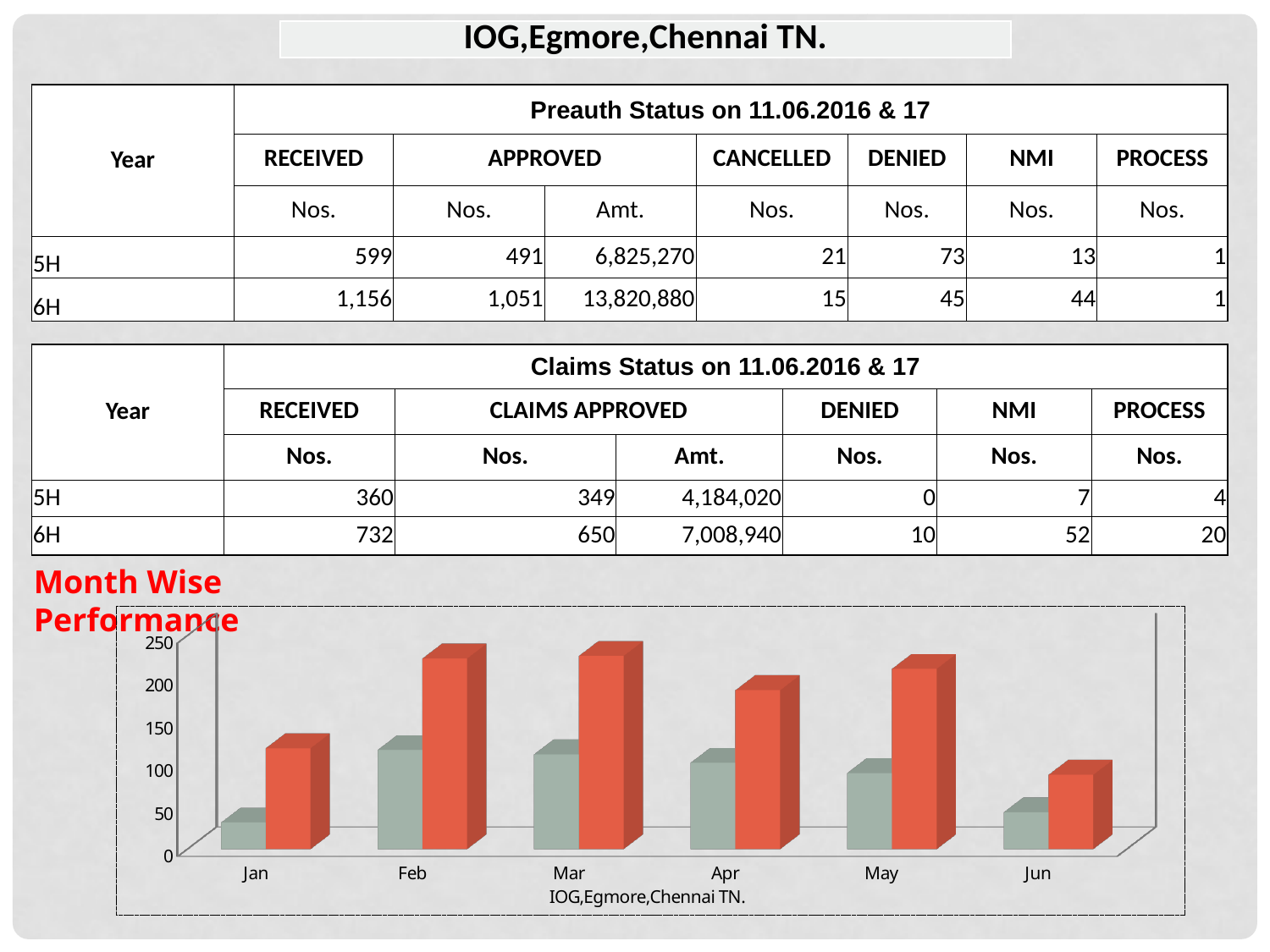
In the bar chart, which is larger: the red bar for Feb or the red bar for Jun? Feb In the bar chart, which month has the lowest grey bar? Jan In the bar chart, is the grey bar for Jun greater or less than 100? less What kind of chart is shown under the heading 'Month Wise Performance'? bar chart In the bar chart, is the red bar for Feb greater or less than 200? greater How many months are shown on the x axis of the bar chart? 6 In the bar chart, is the grey bar for Jan greater or less than 50? less In the bar chart, which month has the lowest red bar? Jun How many bars are plotted for each month in the bar chart? 2 What text appears as the label beneath the x axis of the bar chart? IOG,Egmore,Chennai TN.